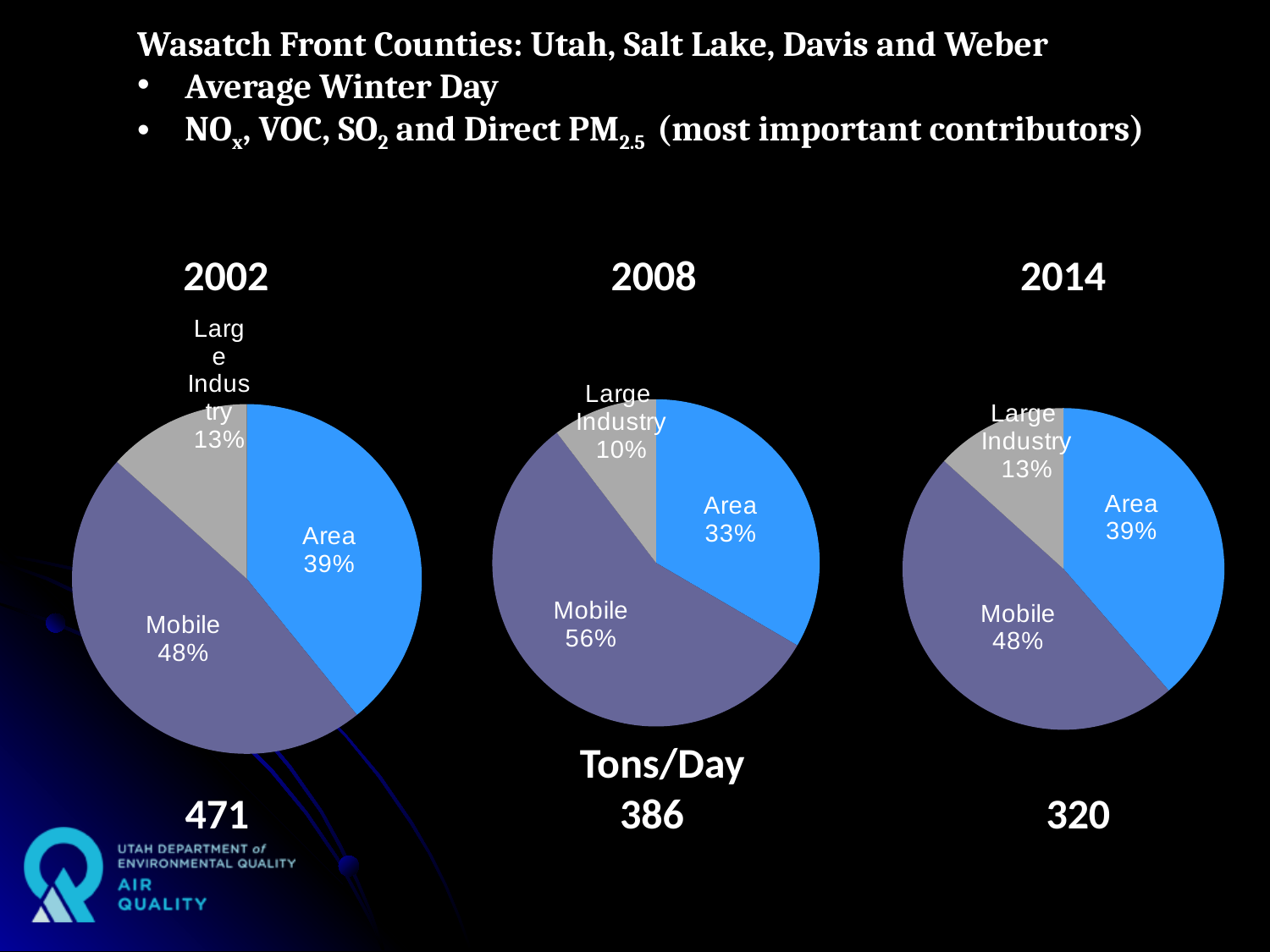
What kind of chart is used for the 2002, 2008 and 2014 data? Pie chart In the 2014 pie chart, what share does Large Industry have? 13% In the 2002 pie chart, which category has the smallest share? Large Industry What is the Tons/Day total shown under the 2008 pie chart? 386 How many slices does the 2008 pie chart have? 3 What is the difference between the Tons/Day totals shown for 2002 and 2014? 151 In the 2008 pie chart, what is the difference between the Mobile share and the Area share? 23% In the 2002 pie chart, what share does Mobile have? 48% In the 2008 pie chart, what share does Area have? 33% What is the Tons/Day total shown under the 2014 pie chart? 320 In the 2014 pie chart, which is larger, the Area share or the Mobile share? Mobile In the 2008 pie chart, which category has the largest share? Mobile